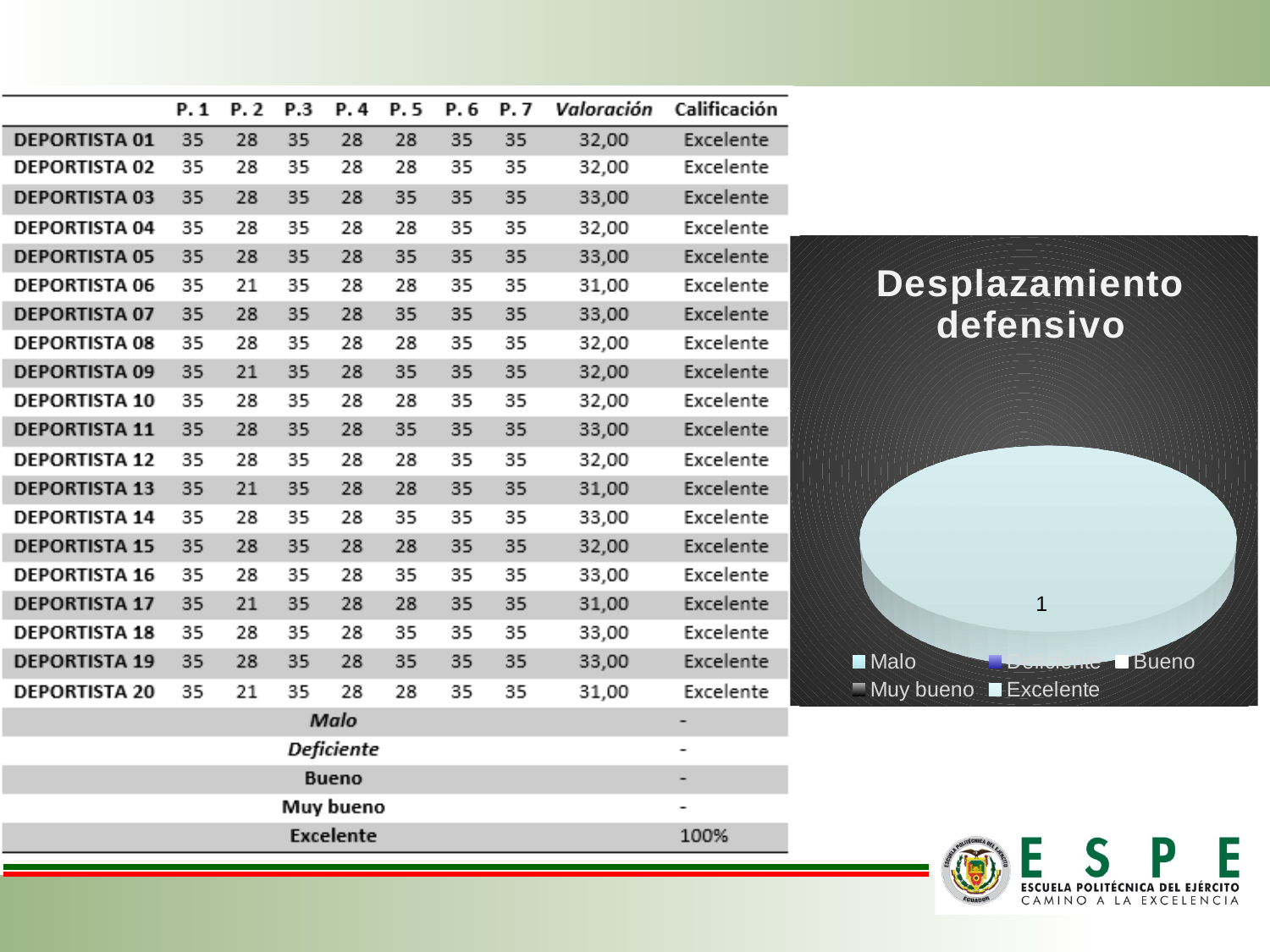
What data label is printed on the pie slice? 1 How many slices are visible in the pie chart? 1 How many entries does the chart's legend list? 5 Which is larger in the pie chart, the share for Excelente or the share for Malo? Excelente Which legend entry is listed first in the chart's legend? Malo What is the title of the chart? Desplazamiento defensivo Which category makes up the entire pie in the chart? Excelente What share of the pie does the Excelente category represent? 100% What kind of chart is shown on the slide? pie chart